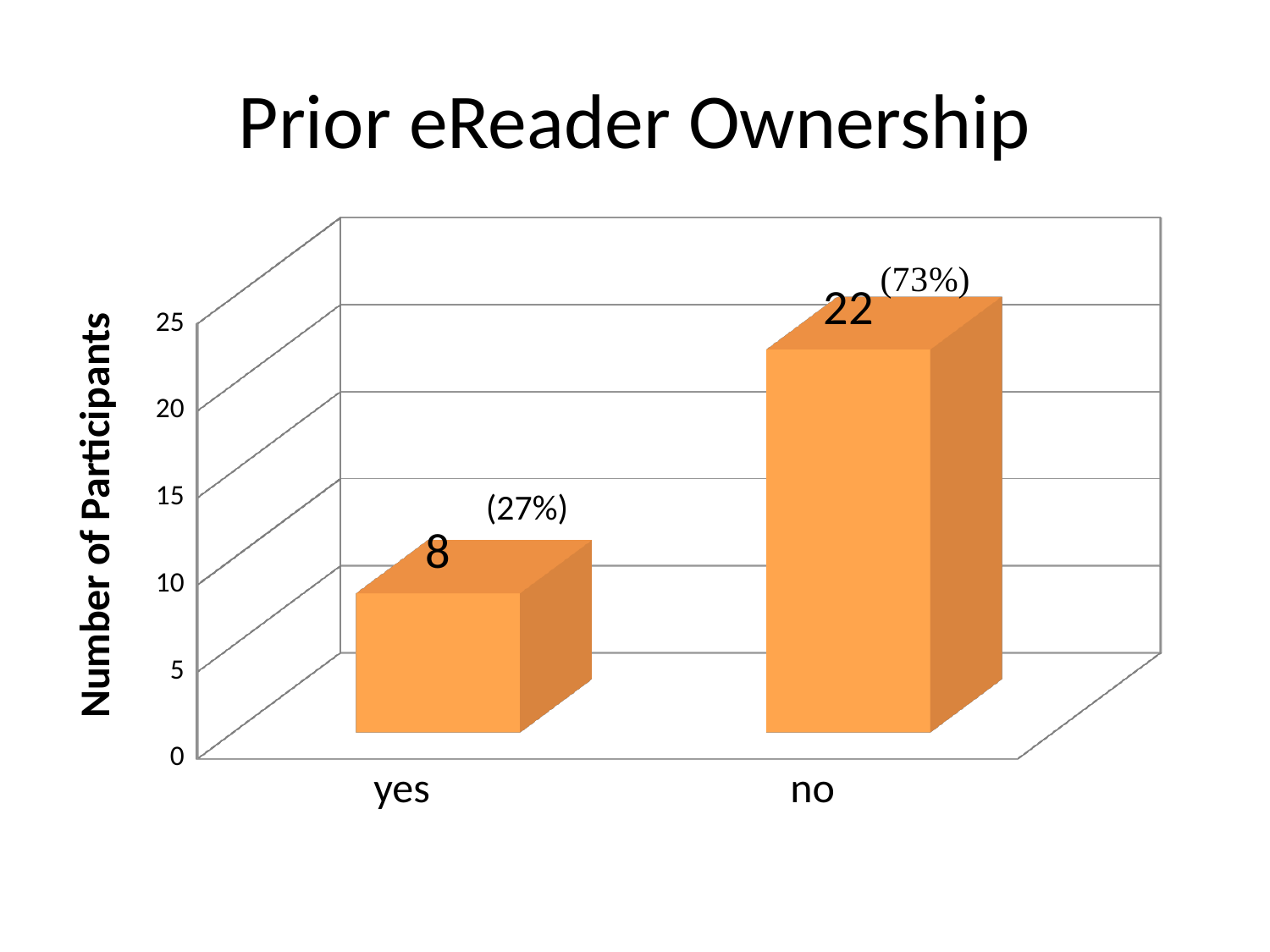
Which category has the lowest number of participants? yes What kind of chart is shown on the slide? bar chart What percentage is shown next to the "no" bar? (73%) Is the value for "no" greater or less than 20? greater What is the number of participants for "no"? 22 What is the difference in number of participants between "no" and "yes"? 14 How many categories are shown on the x axis? 2 What is the title of the chart? Prior eReader Ownership Which has more participants, "yes" or "no"? no Is the value for "yes" greater or less than 10? less What is the number of participants for "yes"? 8 Which category has the highest number of participants? no